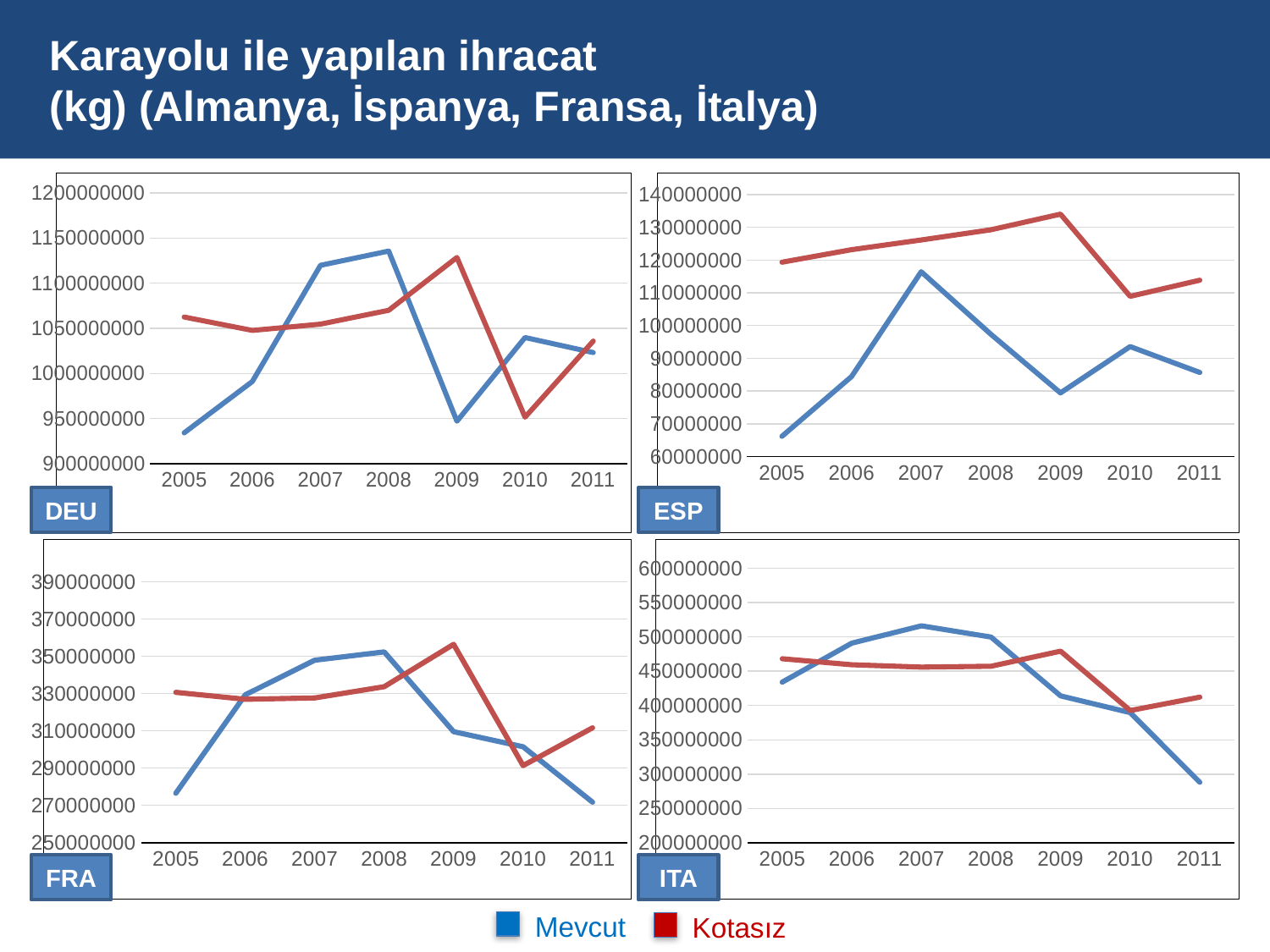
In the ITA chart, is the Mevcut value for 2011 greater or less than 300000000? less In the ESP chart, which series has the larger value in 2005, Mevcut or Kotasız? Kotasız How many series does the legend at the bottom of the slide list? 2 In the FRA chart, in which year does the Mevcut series reach its lowest value? 2011 In the DEU chart, in which year does the Mevcut series reach its highest value? 2008 How many years are shown on the x axis of the FRA chart? 7 In the FRA chart, is the Kotasız value for 2009 greater or less than 350000000? greater In the ITA chart, does the Mevcut series rise or fall from 2008 to 2011? fall In the ESP chart, in which year does the Kotasız series reach its highest value? 2009 In the ESP chart, is the Mevcut value for 2005 greater or less than 70000000? less What kind of chart is the DEU chart? line chart